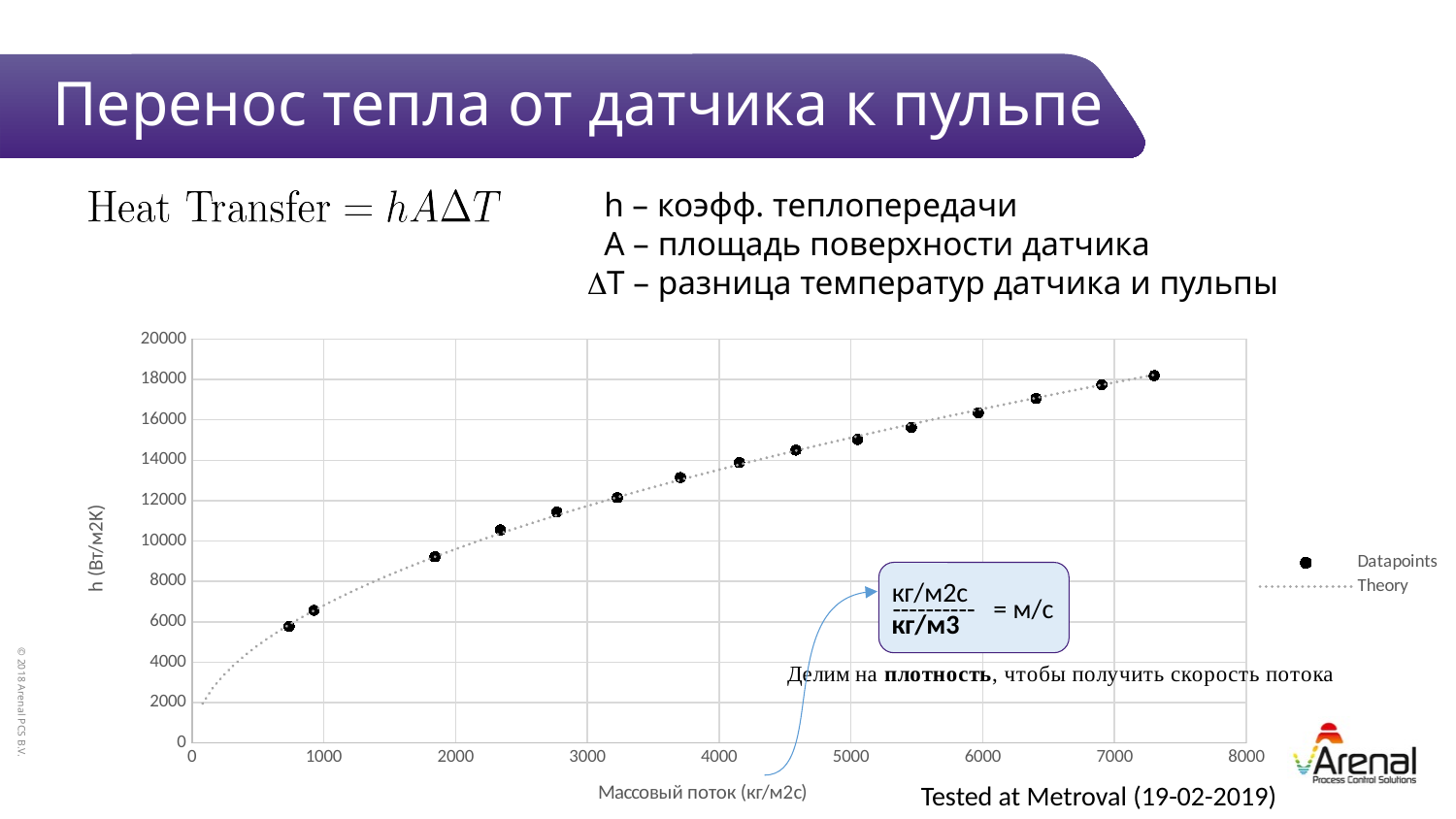
What are the two entries in the chart legend? Datapoints, Theory Do the plotted h values rise or fall as the mass flow increases along the x axis? rise Is the h value of the rightmost data point greater or less than 16000? greater Is the h value of the data point near a mass flow of 2350 greater or less than 12000? less What kind of chart is shown on the slide? scatter chart What is the title of the chart's vertical axis? h (Вт/м2K) How many data points are plotted in the Datapoints series? 15 Is the h value of the leftmost data point greater or less than 8000? less How many series does the chart legend list? 2 Which data point has the highest h value: the one near a mass flow of 7300 or the one near 750? the one near 7300